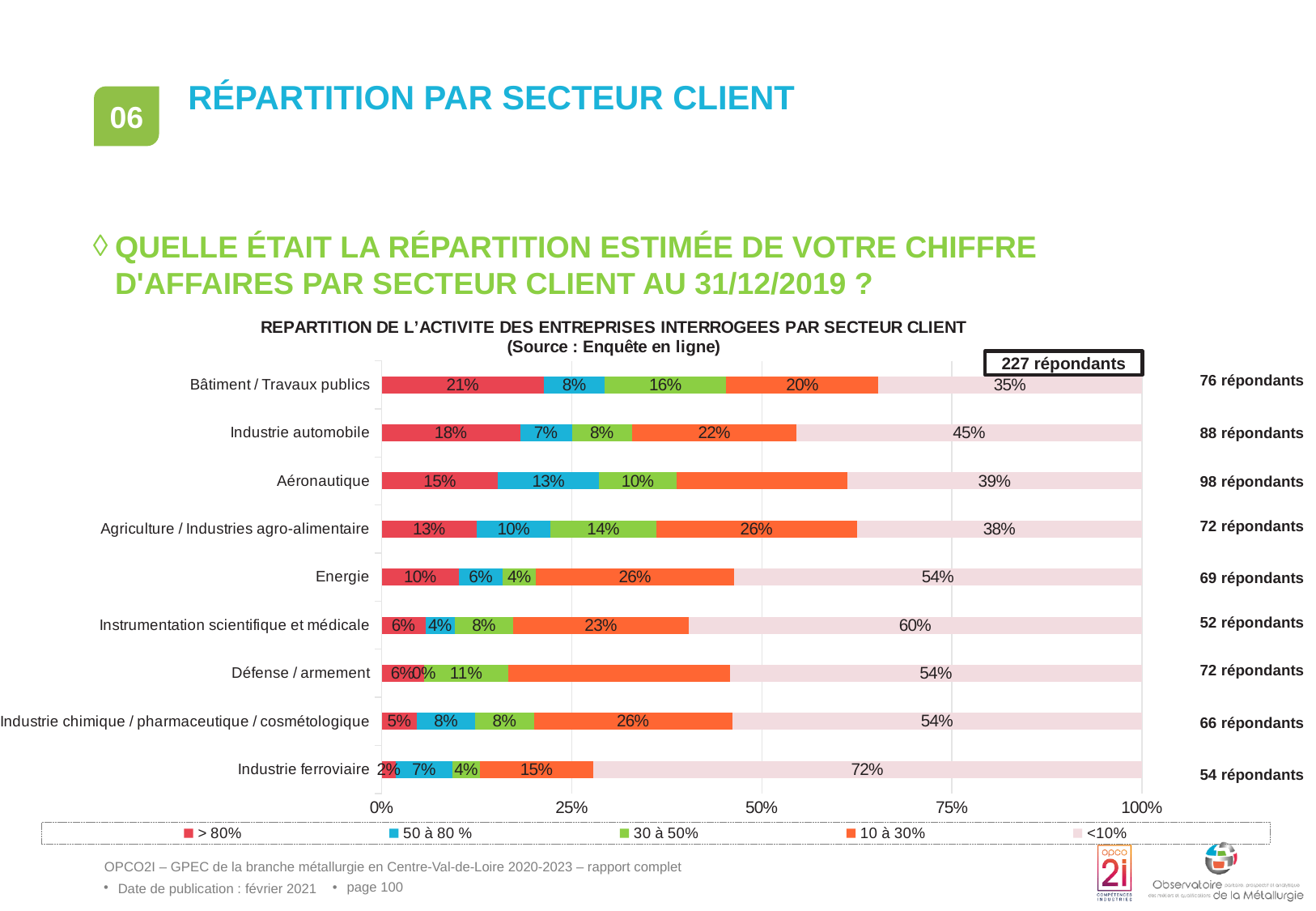
Which sector has the highest '<10%' value? Industrie ferroviaire How many series does the legend list? 5 Which sector has the lowest '> 80%' value? Industrie ferroviaire What kind of chart is shown on the slide? Stacked bar chart What is the value of the '10 à 30%' segment for Agriculture / Industries agro-alimentaire? 26% What is the value of the '50 à 80 %' segment for Aéronautique? 13% What is the difference between the '<10%' values for Industrie automobile and Bâtiment / Travaux publics? 10 percentage points Which is larger: the '> 80%' value for Energie or the '> 80%' value for Industrie chimique / pharmaceutique / cosmétologique? Energie What is the value of the '<10%' segment for Industrie automobile? 45% How many respondents does the box at the top right of the chart report? 227 répondants How many client sectors (categories) are plotted on the chart? 9 What is the value of the '> 80%' segment for Bâtiment / Travaux publics? 21%